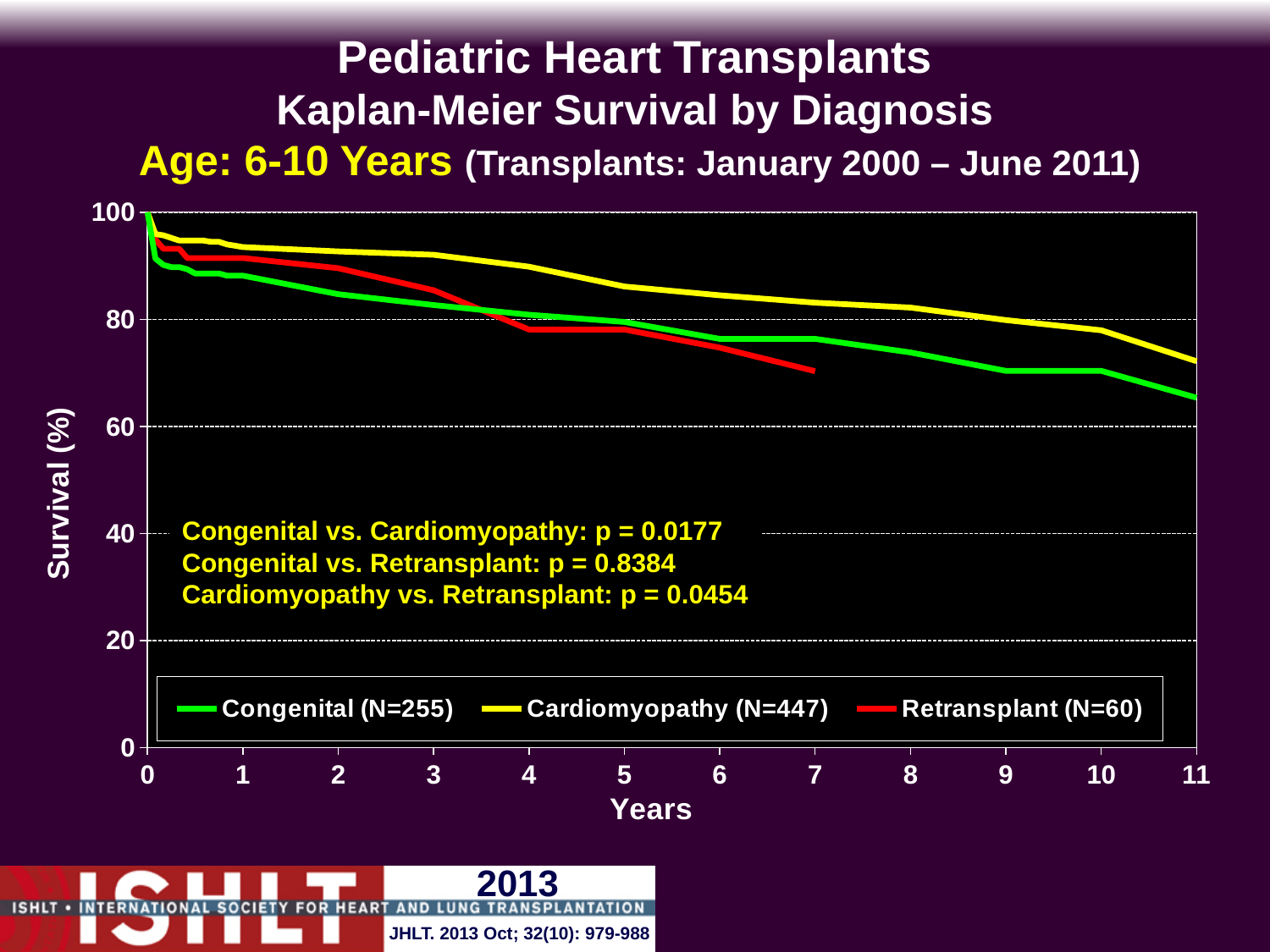
What is the N for the Cardiomyopathy group shown in the legend? N=447 Which diagnosis group has the lowest survival at year 6? Retransplant Is the survival value for Congenital at year 10 greater or less than 80? less What kind of chart is shown on the slide? line chart At year 10, which has higher survival: Congenital or Cardiomyopathy? Cardiomyopathy Is the survival value for Retransplant at year 7 greater or less than 80? less How many series does the legend list? 3 What p-value is shown for Congenital vs. Cardiomyopathy? p = 0.0177 Is the survival value for Cardiomyopathy at year 5 greater or less than 80? greater Which diagnosis group has the highest survival at year 5? Cardiomyopathy Do the survival curves rise or fall as years increase? fall